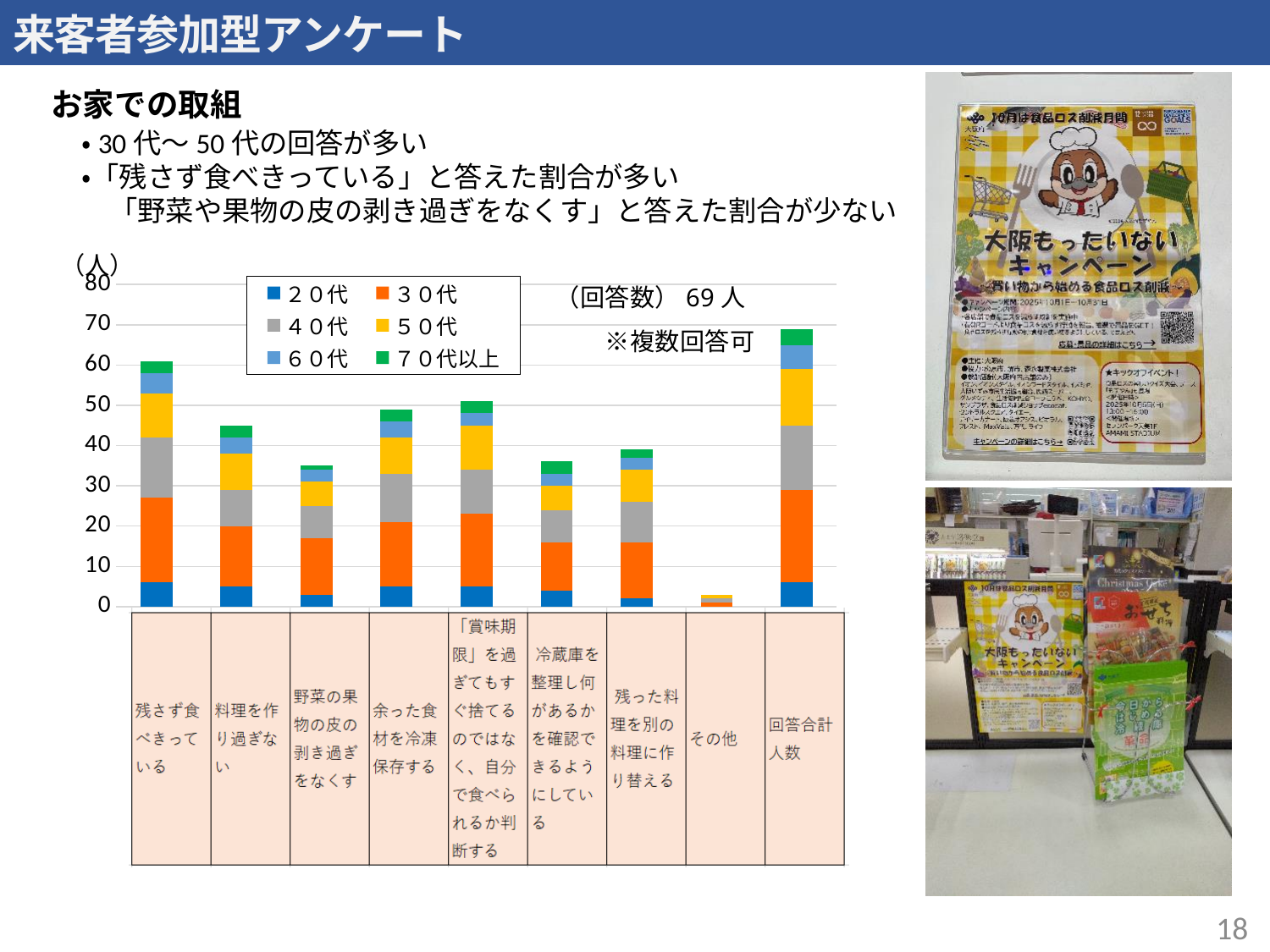
How many series does the chart's legend list? 6 Which has the taller stacked bar: 料理を作り過ぎない or 冷蔵庫を整理し何があるかを確認できるようにしている? 料理を作り過ぎない Is the total bar height for 残さず食べきっている greater or less than 50? greater Which category has the tallest bar in the chart? 回答合計人数 Excluding 回答合計人数, which category has the tallest stacked bar? 残さず食べきっている What unit is shown at the top of the chart's vertical axis? （人） Is the total bar height for その他 greater or less than 10? less Which category has the shortest bar in the chart? その他 How many categories are shown along the x axis of the chart? 9 Is the total bar height for 回答合計人数 greater or less than 60? greater What kind of chart is shown on the slide? stacked bar chart